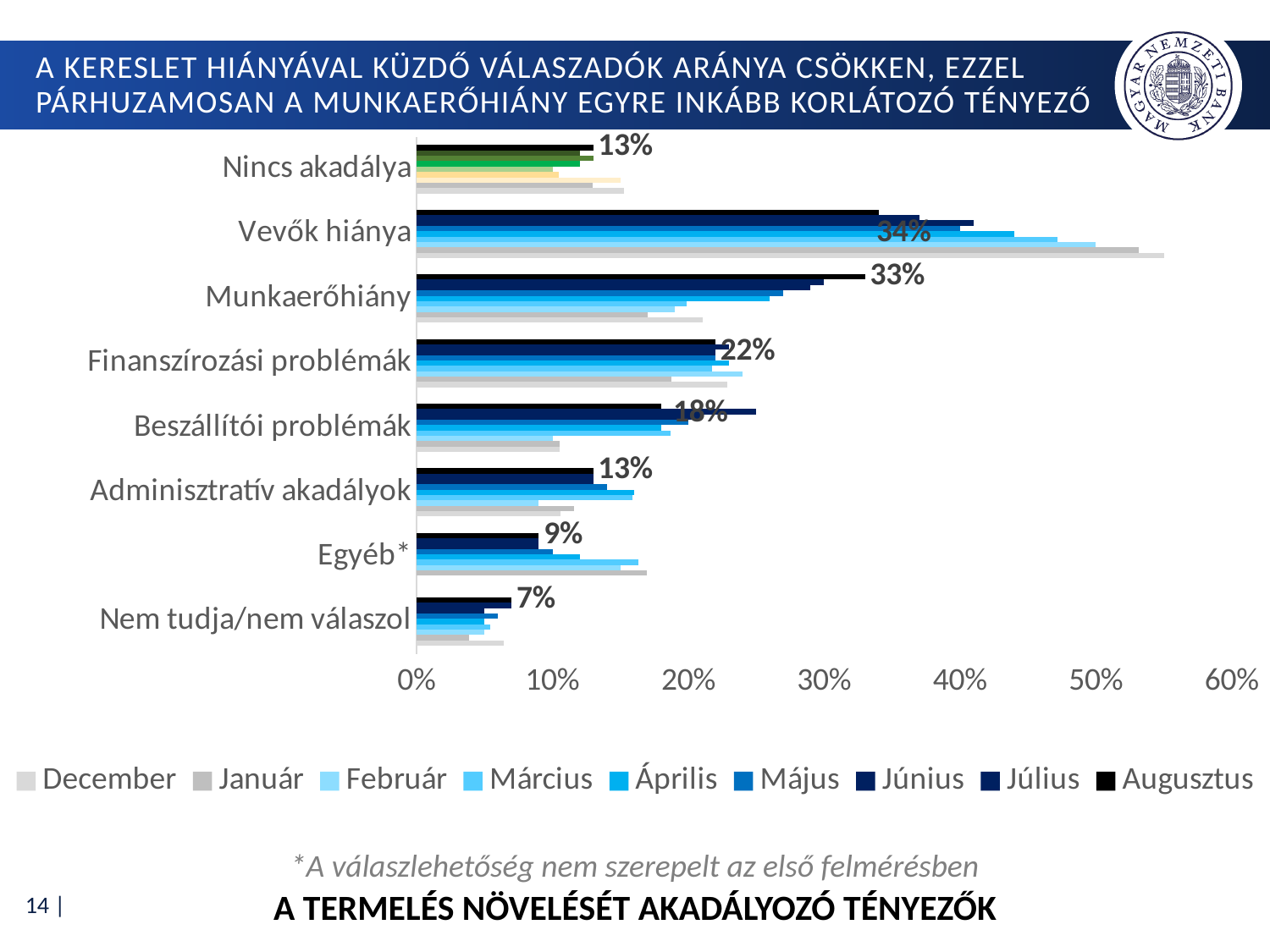
Is the December value for Vevők hiánya greater or less than 50%? greater Which category has the highest Augusztus value? Vevők hiánya What is the difference between the Augusztus values for Finanszírozási problémák and Beszállítói problémák? 4% What is the Augusztus value for Munkaerőhiány? 33% Which is larger for Augusztus: Adminisztratív akadályok or Egyéb*? Adminisztratív akadályok How many categories are shown on the chart? 8 How many series does the legend list? 9 What is the Augusztus value for Nem tudja/nem válaszol? 7% What is the Augusztus value for Vevők hiánya? 34% What kind of chart is shown on the slide? Bar chart What is the Augusztus value for Finanszírozási problémák? 22% Which category has the lowest Augusztus value? Nem tudja/nem válaszol